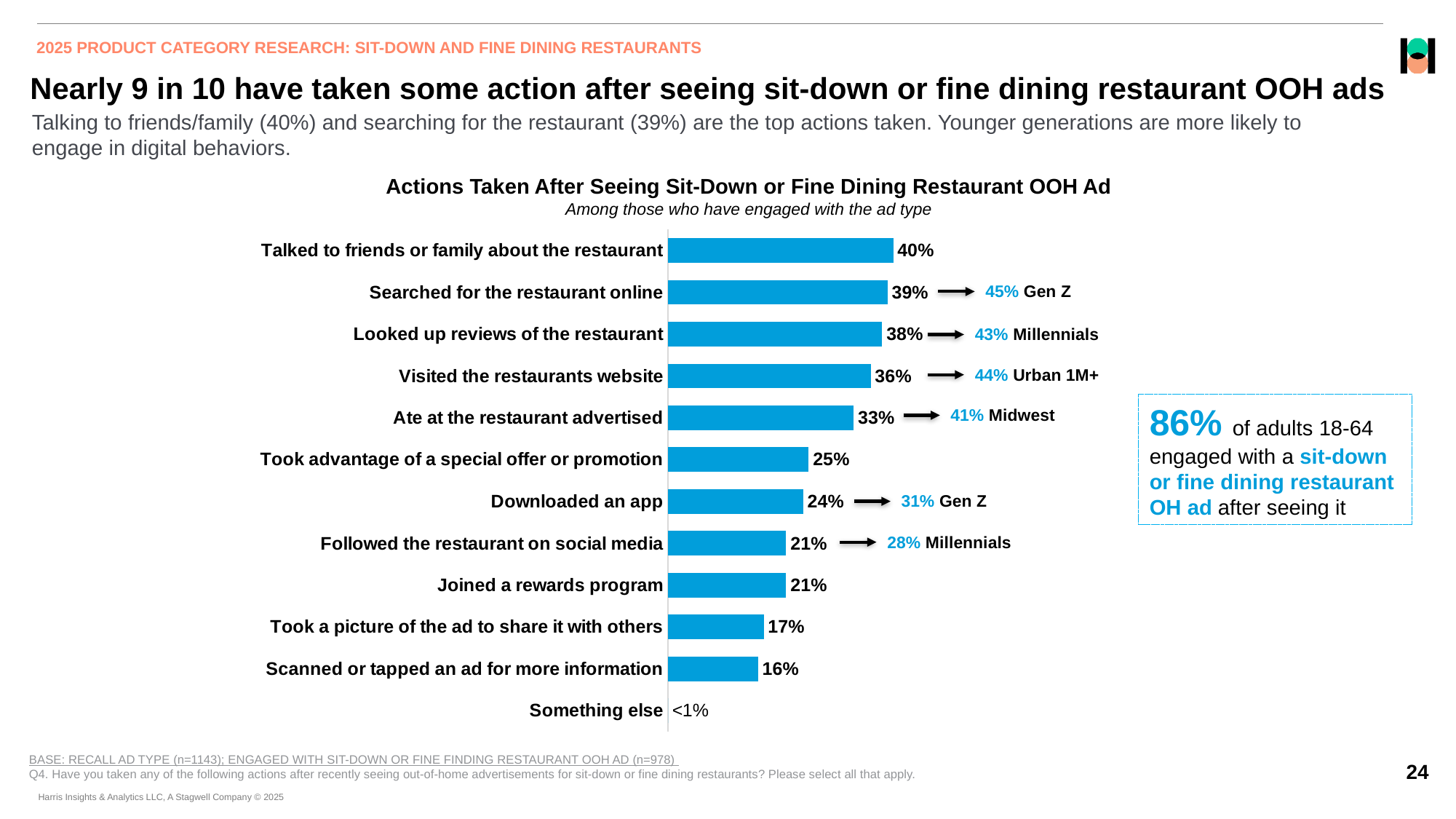
What percentage talked to friends or family about the restaurant? 40% What kind of chart is shown on the slide? Bar chart What percentage downloaded an app? 24% Which action has the lowest percentage? Something else What percentage of Gen Z searched for the restaurant online, according to the callout? 45% What is the title of the chart? Actions Taken After Seeing Sit-Down or Fine Dining Restaurant OOH Ad What percentage scanned or tapped an ad for more information? 16% Which action has the highest percentage? Talked to friends or family about the restaurant What percentage of Millennials followed the restaurant on social media, according to the callout? 28% Which is larger: 'Ate at the restaurant advertised' or 'Took advantage of a special offer or promotion'? Ate at the restaurant advertised What is the difference between 'Searched for the restaurant online' and 'Took a picture of the ad to share it with others'? 22% How many action categories are shown in the chart? 12